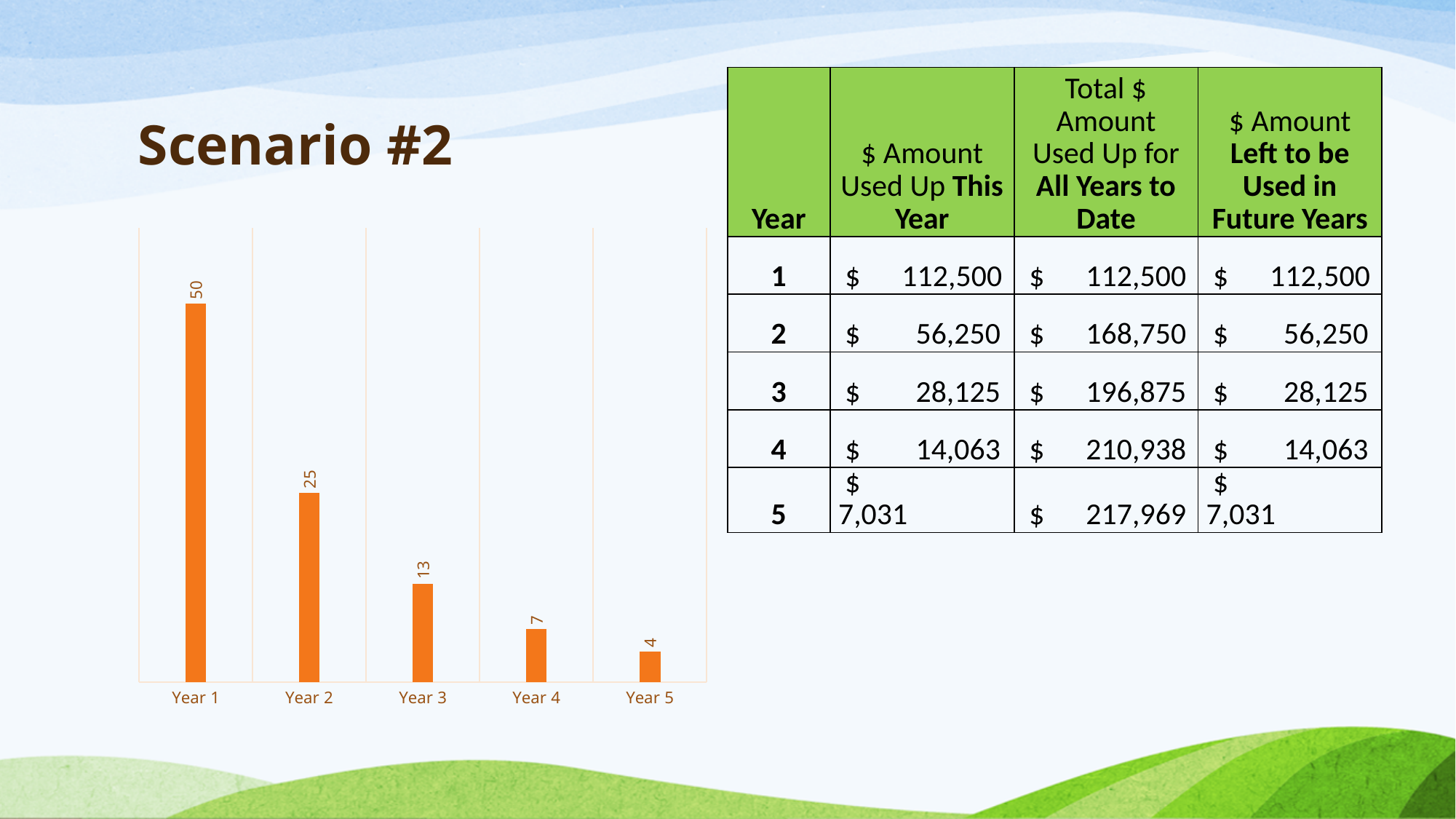
What is the difference between the values for Year 1 and Year 2 in the bar chart? 25 Do the values in the bar chart rise or fall from Year 1 to Year 5? Fall Which year has the lowest value in the bar chart? Year 5 Which is larger in the bar chart, the value for Year 2 or the value for Year 4? Year 2 What is the value for Year 3 in the bar chart? 13 What colour are the bars in the chart? Orange Which year has the highest value in the bar chart? Year 1 What is the value for Year 5 in the bar chart? 4 What kind of chart is shown on the slide? Bar chart What is the difference between the values for Year 3 and Year 4 in the bar chart? 6 What is the value for Year 1 in the bar chart? 50 How many bars are shown in the bar chart? 5